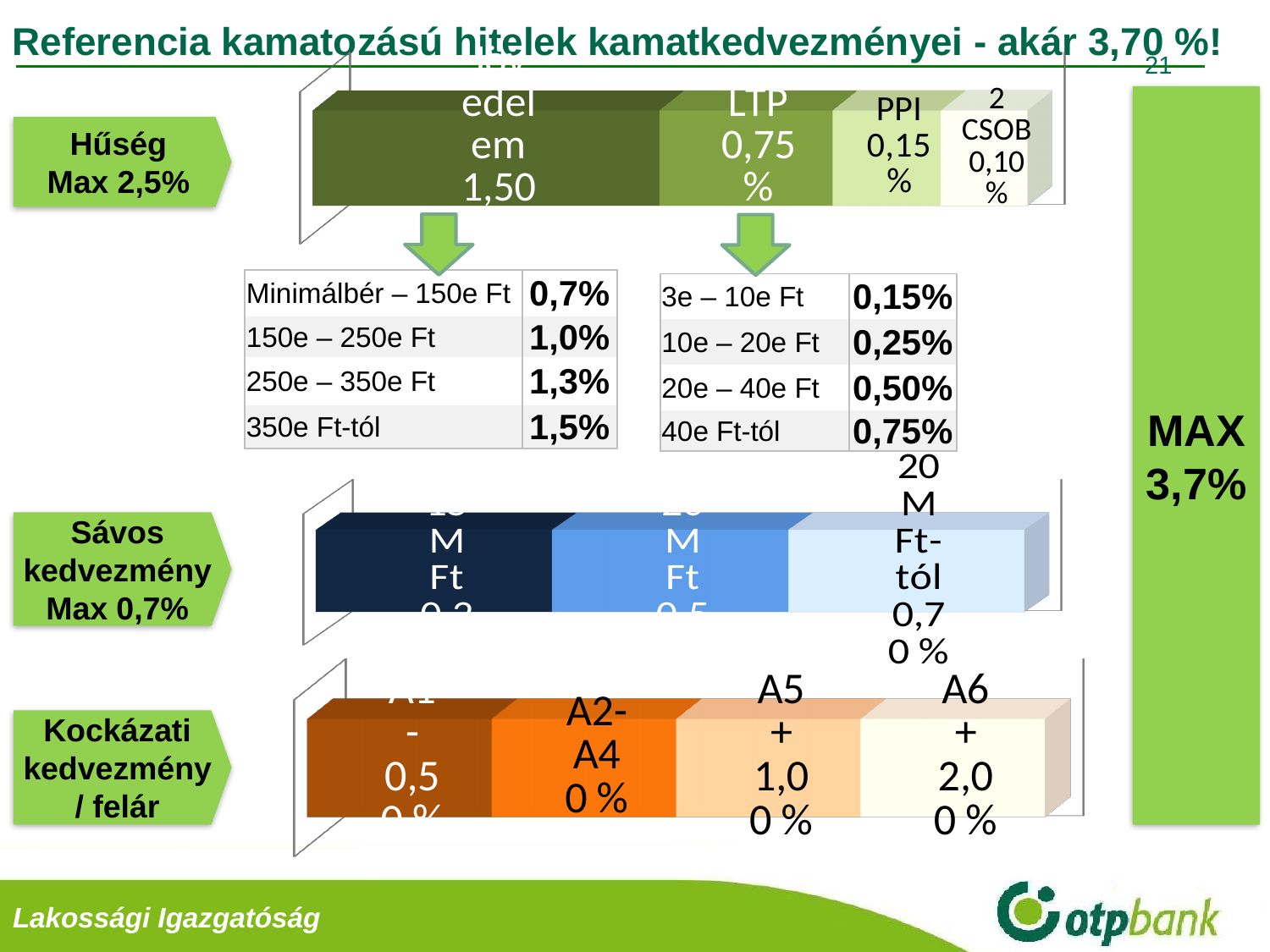
In the top chart (Hűség), what value is shown for the PPI segment? 0,15 % How many segments does the middle chart (Sávos kedvezmény) contain? 3 In the top chart (Hűség), what value is shown for the LTP segment? 0,75 % What kind of chart is the top chart next to the 'Hűség Max 2,5%' label? bar chart In the bottom chart (Kockázati kedvezmény / felár), what value is shown for the A2-A4 segment? 0 % In the top chart (Hűség), which segment has the lowest value? CSOB How many segments does the top chart (Hűség) contain? 4 In the top chart (Hűség), what value is shown for the CSOB segment? 0,10 % In the top chart (Hűség), which is larger, the LTP value or the PPI value? LTP In the bottom chart (Kockázati kedvezmény / felár), what value is shown for the A6 segment? + 2,00 % In the middle chart (Sávos kedvezmény), what value is shown for the '20 M Ft-tól' segment? 0,70 % In the top chart (Hűség), what is the difference between the LTP value and the PPI value? 0,60 %